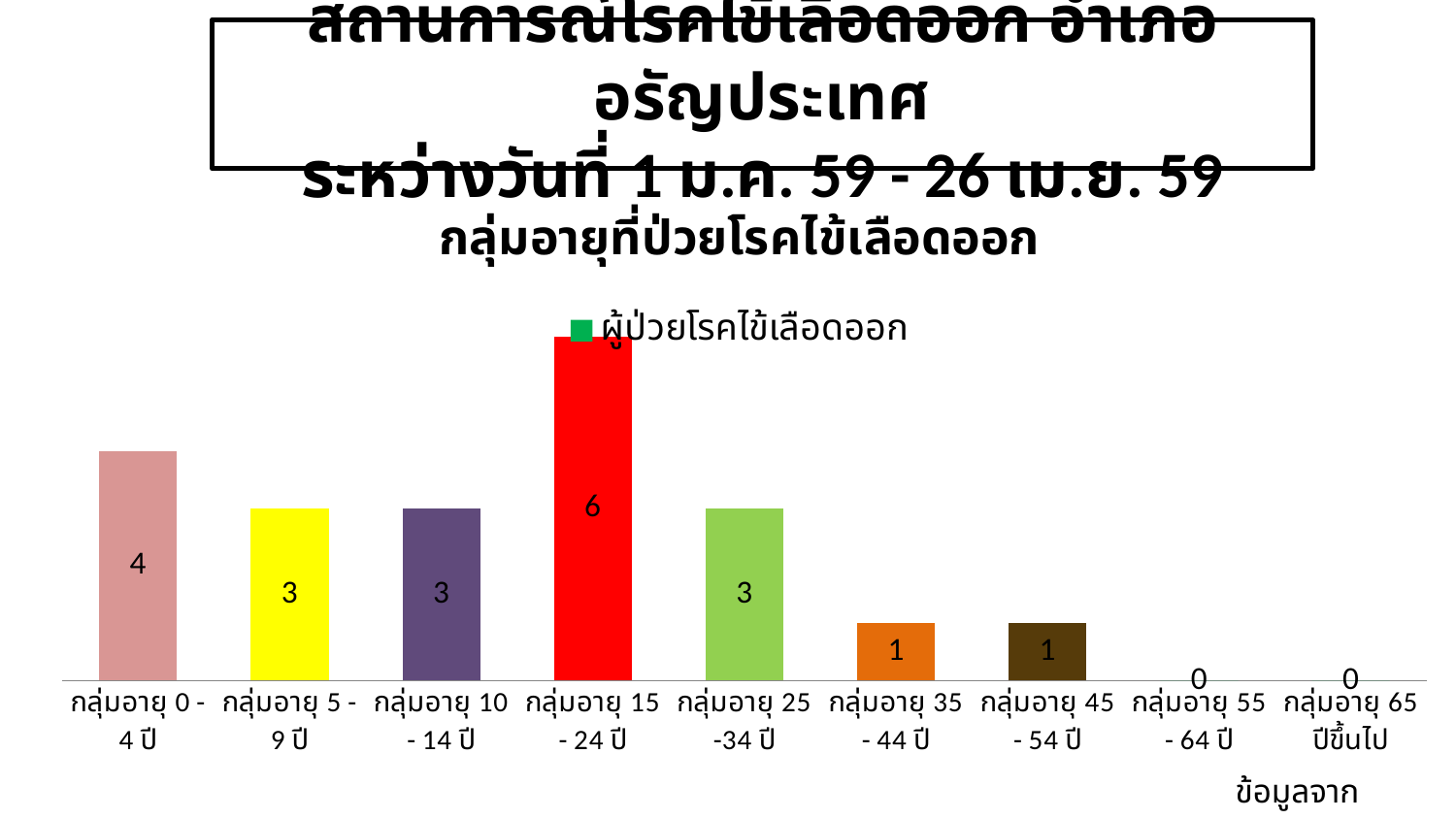
How many series does the legend list? 1 What type of chart is shown on the slide? bar chart Which is larger, the value for กลุ่มอายุ 0 - 4 ปี or the value for กลุ่มอายุ 25 - 34 ปี? กลุ่มอายุ 0 - 4 ปี What is the value for the age group กลุ่มอายุ 35 - 44 ปี? 1 What is the value for the age group กลุ่มอายุ 0 - 4 ปี? 4 What is the value for the age group กลุ่มอายุ 15 - 24 ปี? 6 What is the difference between the values for กลุ่มอายุ 15 - 24 ปี and กลุ่มอายุ 0 - 4 ปี? 2 How many age group categories are shown on the x axis? 9 What is the value for the age group กลุ่มอายุ 65 ปีขึ้นไป? 0 What is the title of the chart? กลุ่มอายุที่ป่วยโรคไข้เลือดออก Which age group has the highest value? กลุ่มอายุ 15 - 24 ปี What is the legend entry for the series? ผู้ป่วยโรคไข้เลือดออก